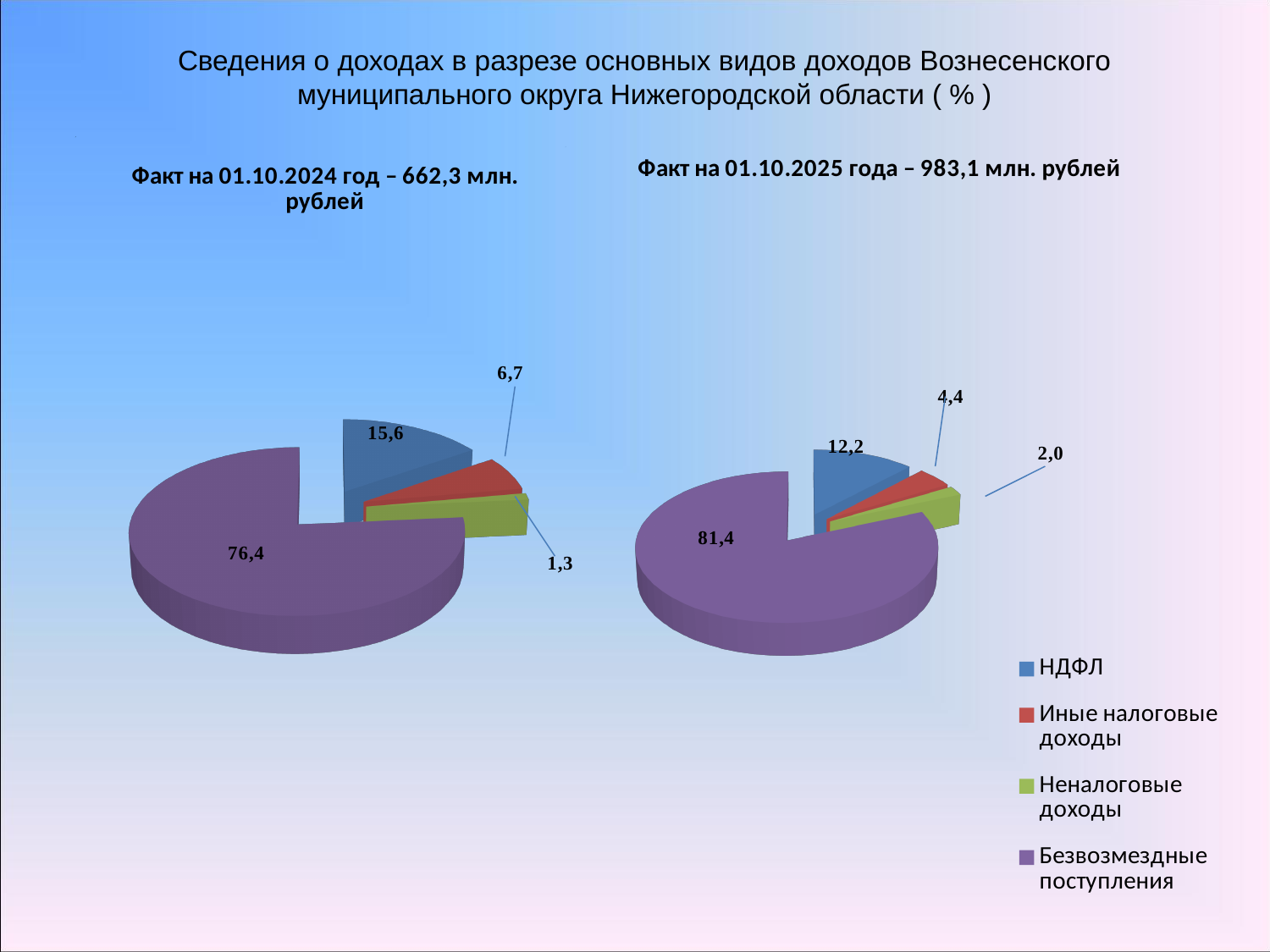
What is the difference between the НДФЛ value in the left chart (01.10.2024) and the НДФЛ value in the right chart (01.10.2025)? 3,4 In the left pie chart (Факт на 01.10.2024 год), which category has the smallest share? Неналоговые доходы In the right pie chart (Факт на 01.10.2025 года), which category has the largest share? Безвозмездные поступления In the left pie chart (Факт на 01.10.2024 год), what is the value for Безвозмездные поступления? 76,4 What total amount is stated in the title of the right chart (Факт на 01.10.2025 года)? 983,1 млн. рублей What colour represents Безвозмездные поступления in the legend? Purple In the left pie chart (Факт на 01.10.2024 год), what is the value for Иные налоговые доходы? 6,7 In the right pie chart (Факт на 01.10.2025 года), what is the value for Неналоговые доходы? 2,0 Which is larger: Иные налоговые доходы in the left chart (01.10.2024) or Иные налоговые доходы in the right chart (01.10.2025)? Left chart (01.10.2024), 6,7 What type of chart is used on this slide? Pie chart How many categories does each pie chart show? 4 In the right pie chart (Факт на 01.10.2025 года), what is the value for НДФЛ? 12,2